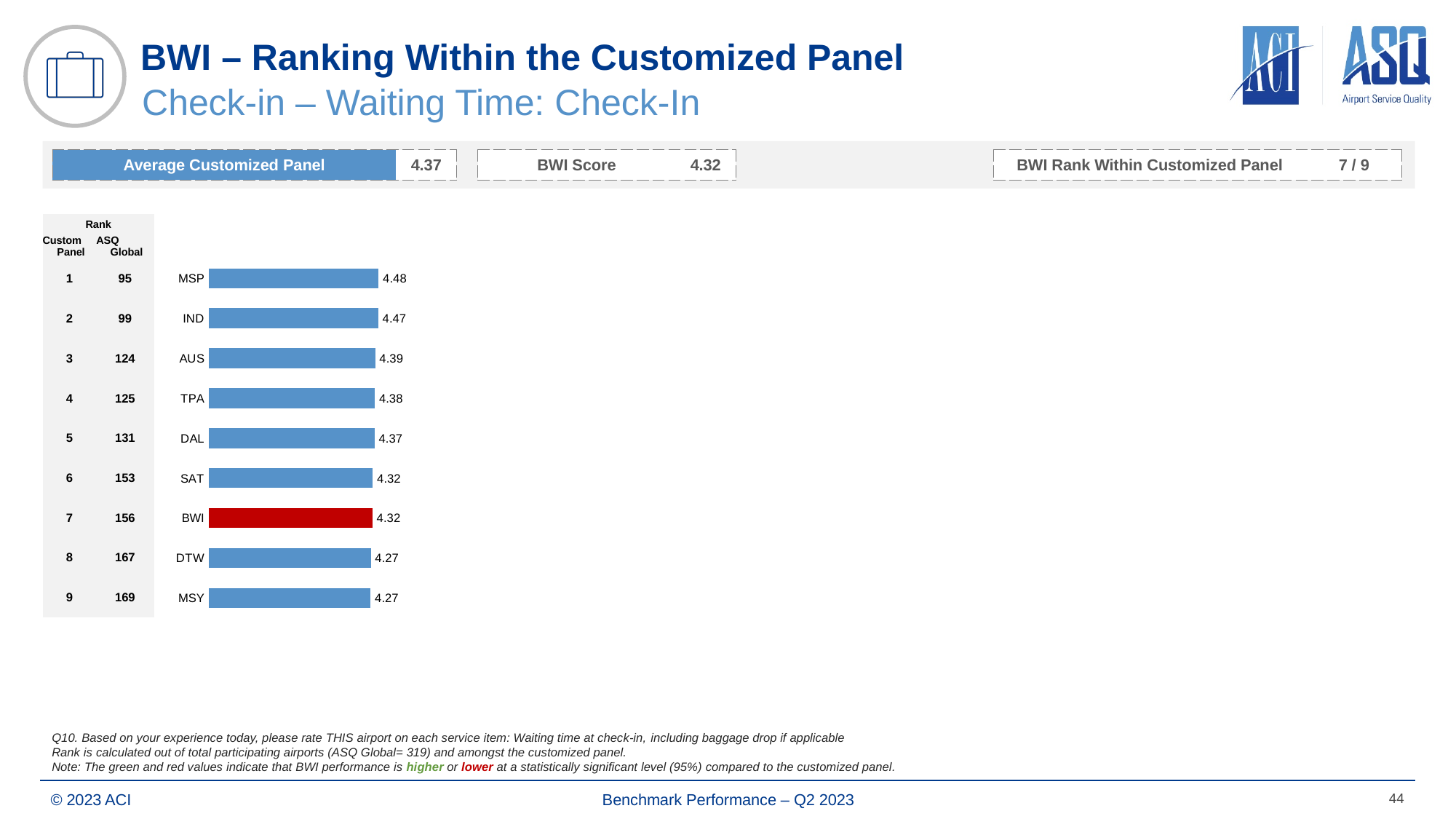
What is the difference between the values for MSP and MSY? 0.21 What is the value for TPA? 4.38 Which is larger, the value for IND or the value for DAL? IND What is the value for DTW? 4.27 What kind of chart is shown? Bar chart What is the Average Customized Panel value shown on the slide? 4.37 Which airport has the highest value? MSP What is the value for MSP? 4.48 What is the difference between the values for AUS and BWI? 0.07 Which bar is coloured red? BWI What is the value for BWI? 4.32 How many airports are shown in the chart? 9